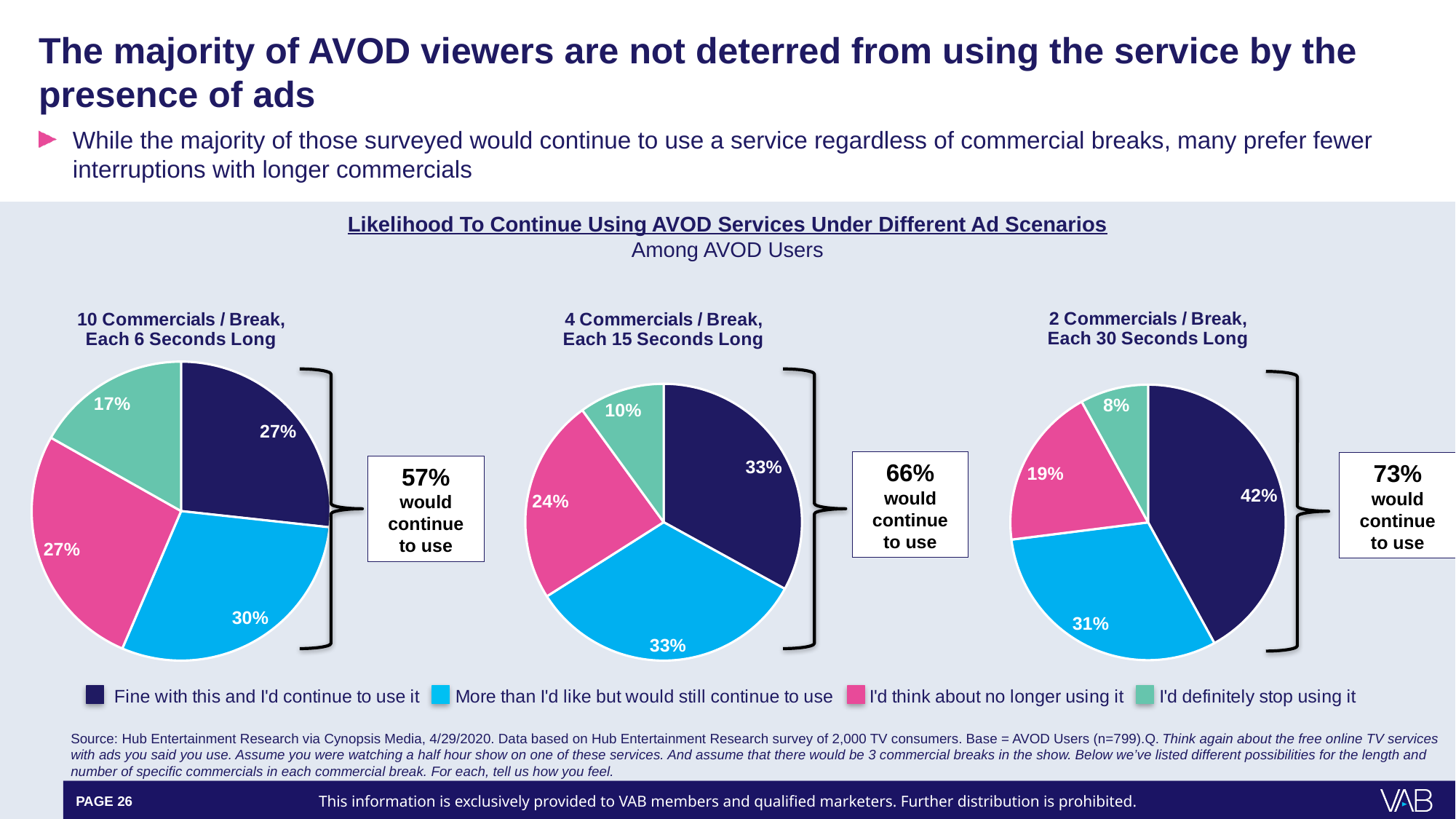
In the '2 Commercials / Break, Each 30 Seconds Long' pie chart, what share said 'I'd definitely stop using it'? 8% In the '10 Commercials / Break, Each 6 Seconds Long' pie chart, what share of AVOD users said 'Fine with this and I'd continue to use it'? 27% What is the title of the chart section on the slide? Likelihood To Continue Using AVOD Services Under Different Ad Scenarios According to the callout next to the '2 Commercials / Break, Each 30 Seconds Long' pie chart, what percentage would continue to use the service? 73% In the '10 Commercials / Break, Each 6 Seconds Long' pie chart, which response has the smallest slice? I'd definitely stop using it How many slices does each pie chart on the slide have? 4 In the '2 Commercials / Break, Each 30 Seconds Long' pie chart, which response has the largest slice? Fine with this and I'd continue to use it In the '4 Commercials / Break, Each 15 Seconds Long' pie chart, what share said 'I'd think about no longer using it'? 24% How many entries does the legend list? 4 What type of chart is used to show the '4 Commercials / Break, Each 15 Seconds Long' data? Pie chart Which is larger in the '2 Commercials / Break, Each 30 Seconds Long' pie chart: 'Fine with this and I'd continue to use it' or 'More than I'd like but would still continue to use'? Fine with this and I'd continue to use it In the '4 Commercials / Break, Each 15 Seconds Long' pie chart, what is the difference between the 'I'd think about no longer using it' slice and the 'I'd definitely stop using it' slice? 14 percentage points